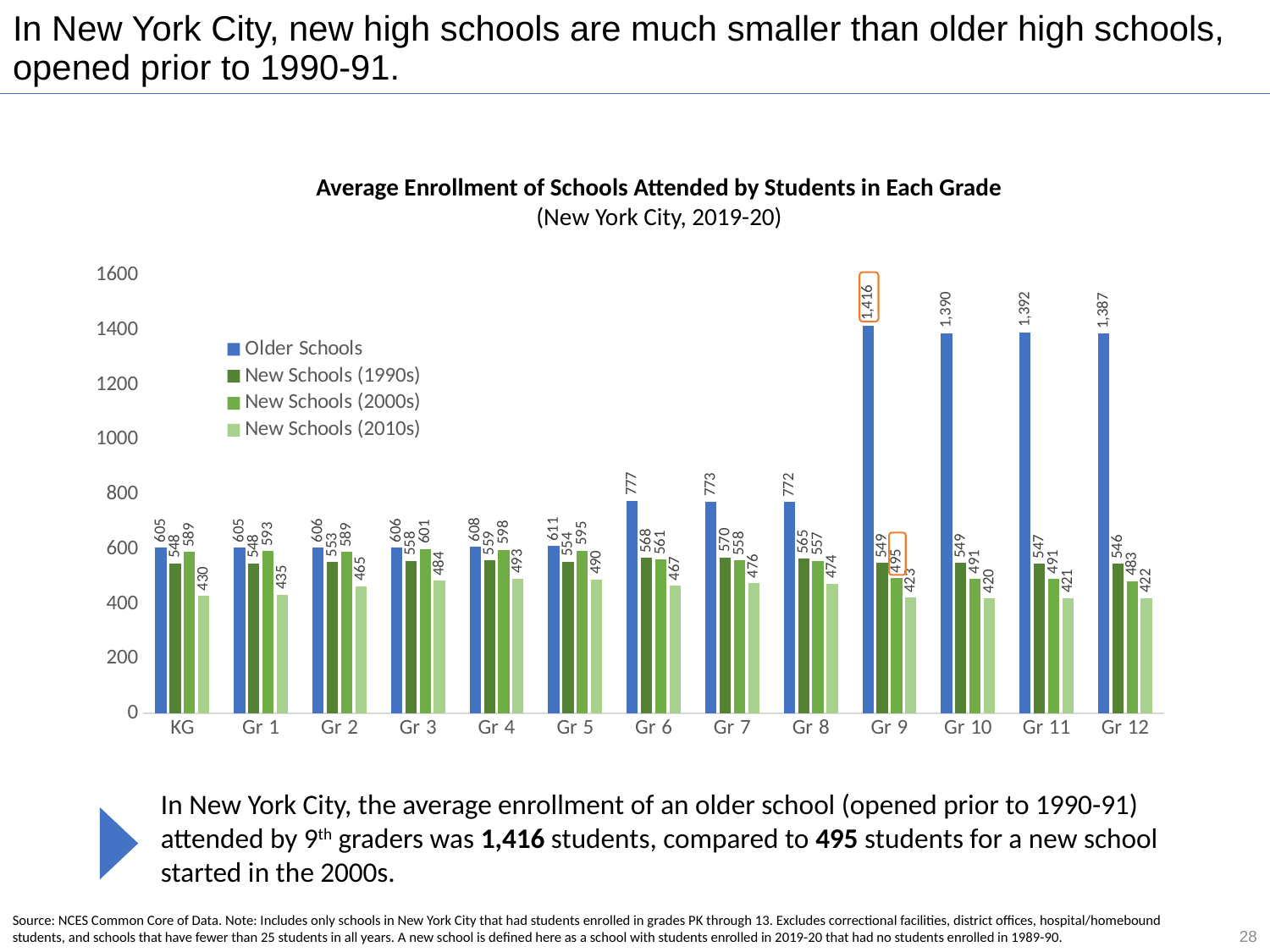
Is the Older Schools value for Gr 12 greater or less than 1200? greater What is the average enrollment of New Schools (2000s) attended by Gr 9 students? 495 What is the average enrollment of New Schools (1990s) attended by Gr 7 students? 570 What is the average enrollment of Older Schools attended by Gr 9 students? 1,416 What is the average enrollment of New Schools (2010s) attended by KG students? 430 For Gr 3, which is larger: the New Schools (1990s) value or the New Schools (2000s) value? New Schools (2000s) How many series does the legend list? 4 What is the difference between the Older Schools and New Schools (2000s) values for Gr 9? 921 How many grade categories are shown on the x axis? 13 Which grade has the lowest average enrollment for New Schools (2010s)? Gr 10 What kind of chart is shown on the slide? Bar chart Which grade has the highest average enrollment for Older Schools? Gr 9